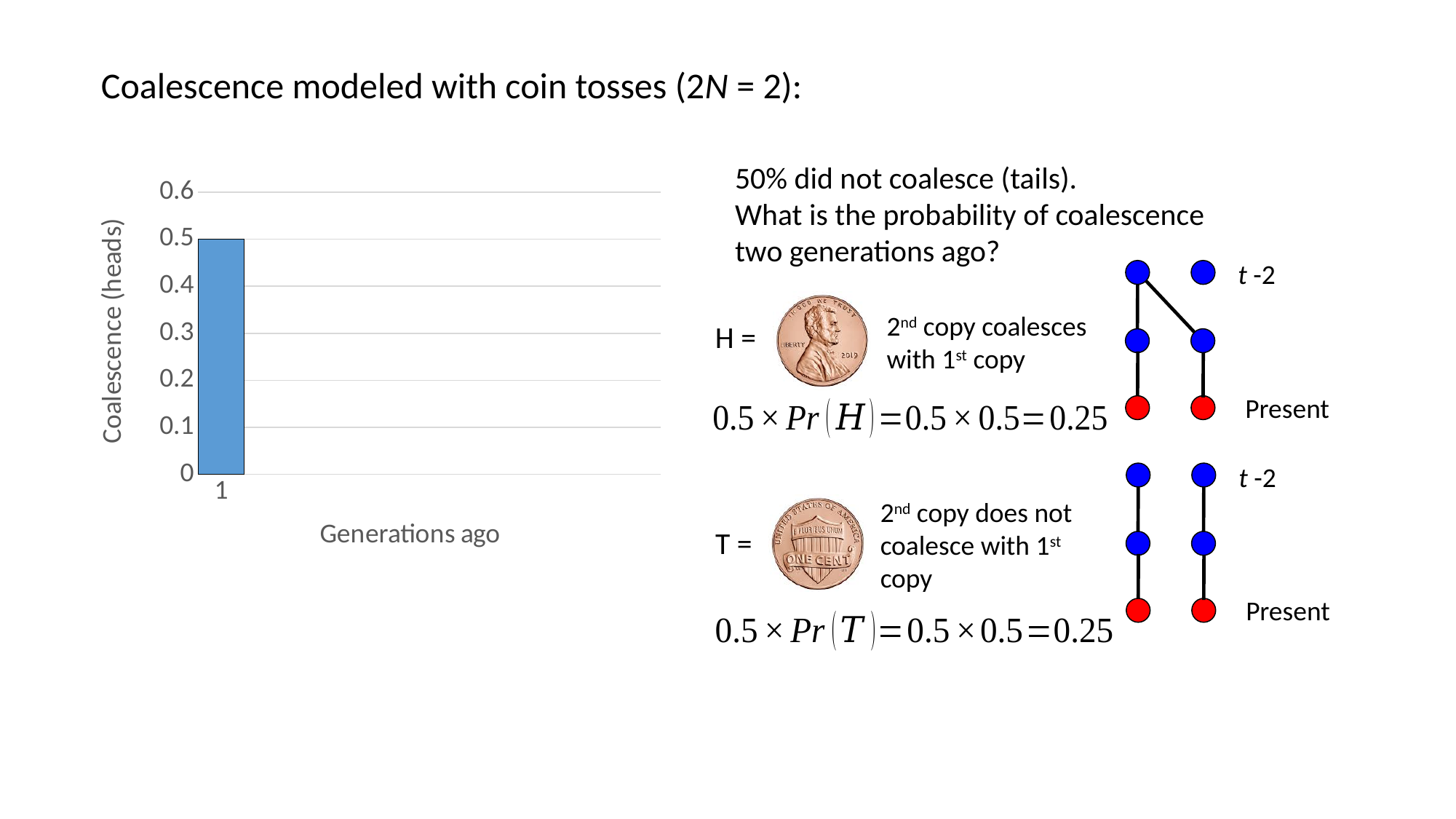
What is the highest value shown on the vertical axis of the chart? 0.6 How many bars are plotted in the chart? 1 Is the value for generation 1 greater or less than 0.6? less What is the label of the horizontal axis of the chart? Generations ago Is the value for generation 1 greater or less than 0.4? greater What is the label of the vertical axis of the chart? Coalescence (heads) What is the value of the bar for generation 1 in the chart? 0.5 What kind of chart is shown on the slide? bar chart